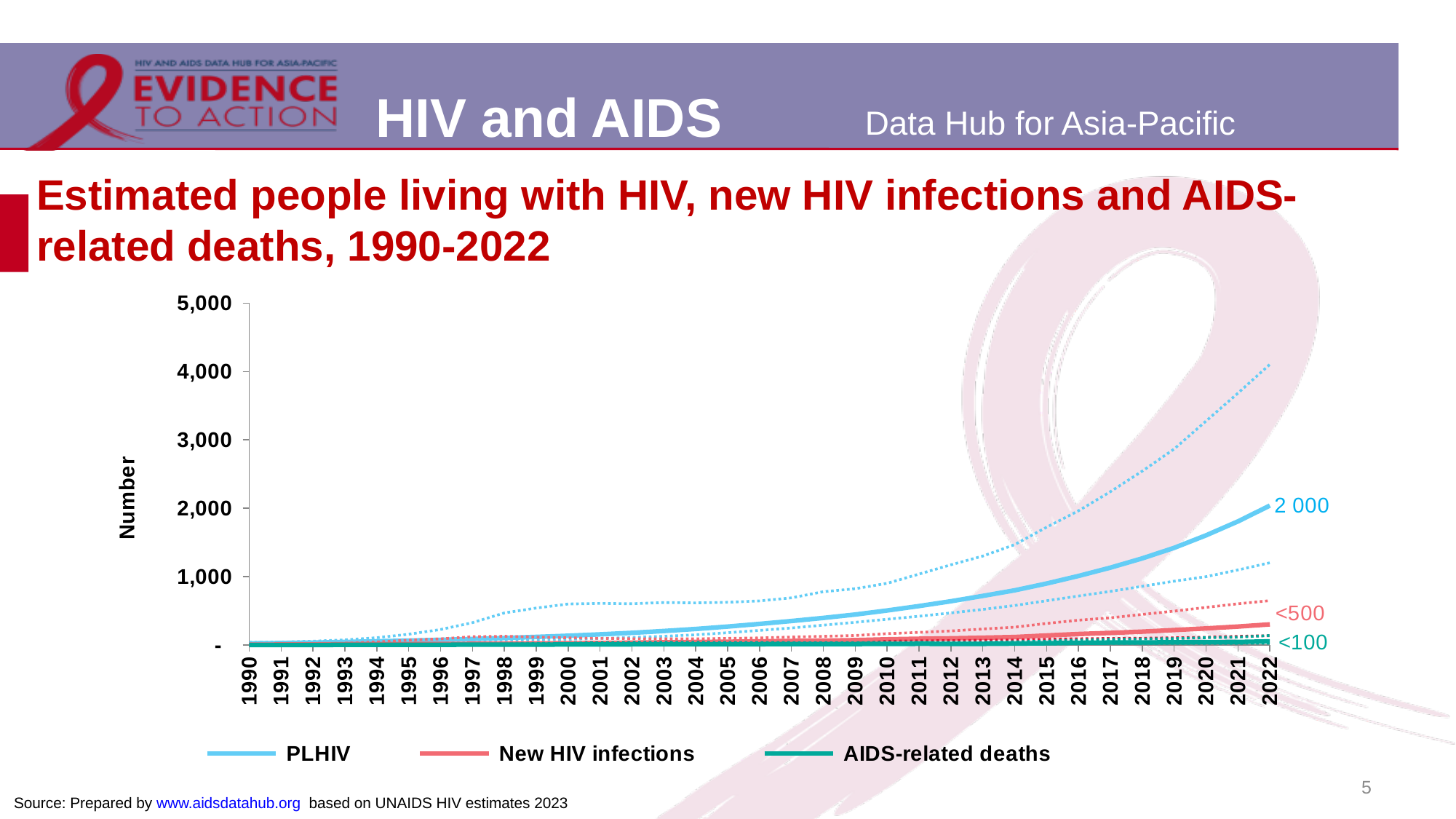
How many years are shown on the x axis? 33 Which series has the highest value in 2022? PLHIV Does the PLHIV line rise or fall from 1990 to 2022? rise What is the labelled value for PLHIV in 2022? 2 000 Is the value for PLHIV in 2010 greater or less than 1,000? less What is the labelled value for AIDS-related deaths in 2022? <100 How many series does the legend list? 3 What type of chart is shown on the slide? line chart Which series has the lowest value in 2022? AIDS-related deaths What is the labelled value for New HIV infections in 2022? <500 Which is larger in 2022, PLHIV or New HIV infections? PLHIV What is the label on the y axis? Number